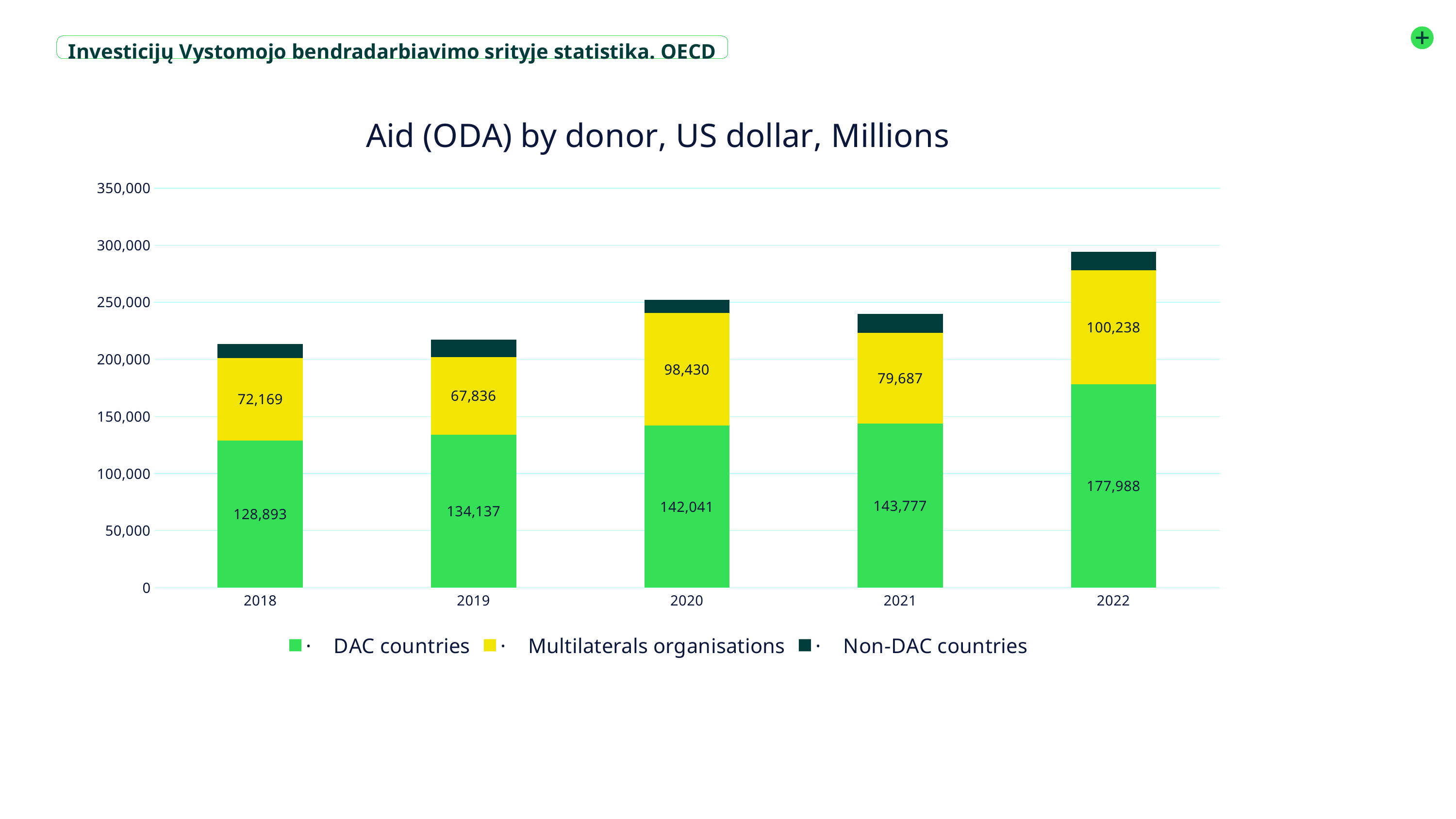
Which year has the highest value for Multilaterals organisations? 2022 What kind of chart is shown on the slide? Stacked bar chart What is the difference between the DAC countries values for 2022 and 2021? 34,211 What is the value for DAC countries in 2022? 177,988 Do the DAC countries values rise or fall from 2018 to 2022? Rise Which is larger: the Multilaterals organisations value for 2019 or for 2021? 2021 Is the total stacked bar for 2022 greater or less than 250,000? greater Which year has the lowest value for DAC countries? 2018 What is the value for DAC countries in 2018? 128,893 What is the value for Multilaterals organisations in 2020? 98,430 How many years are shown on the x axis? 5 How many series does the legend list? 3